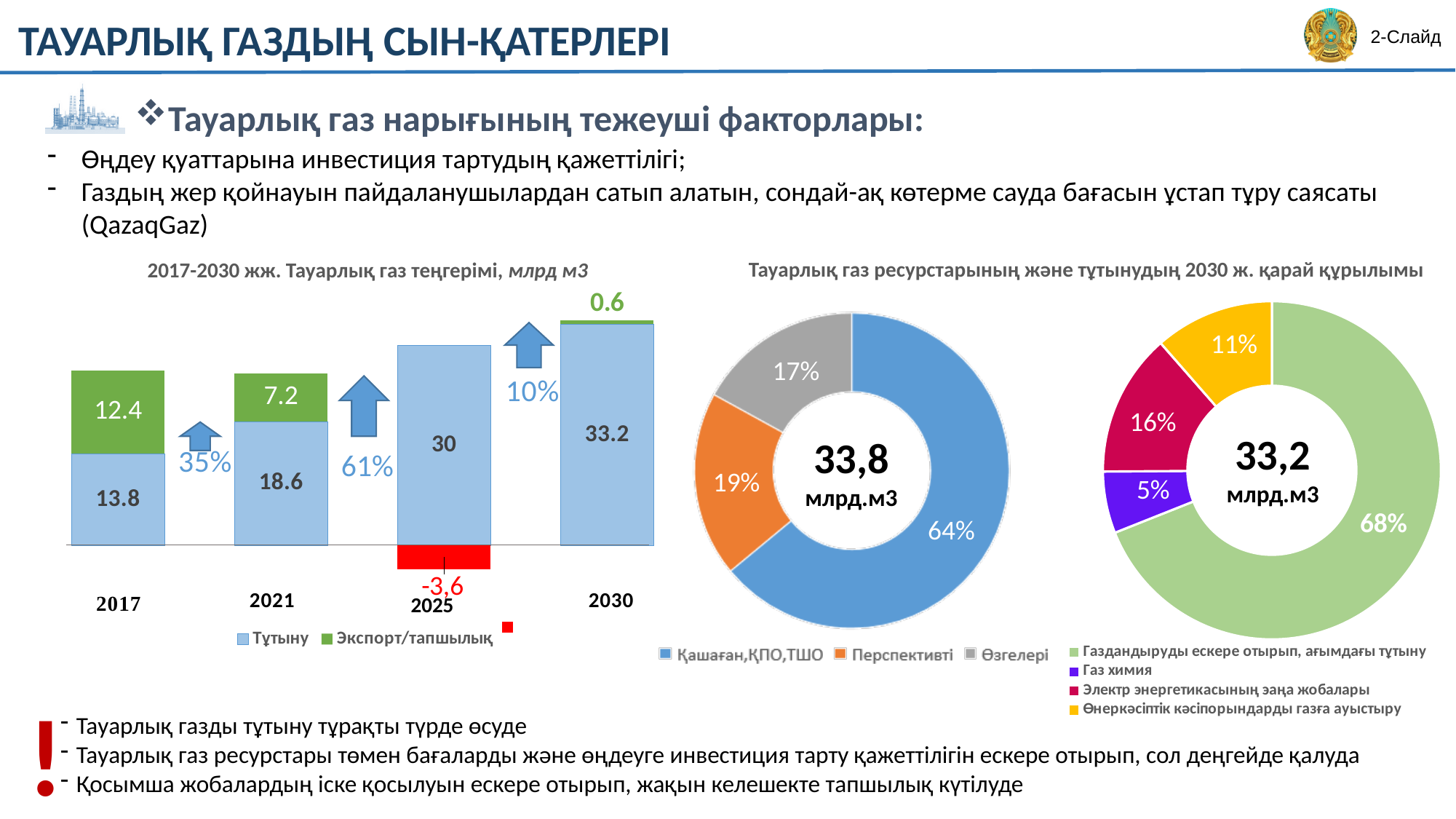
In the left donut chart under 'Тауарлық газ ресурстарының және тұтынудың 2030 ж. қарай құрылымы', what share is Перспективті? 19% In the bar chart '2017-2030 жж. Тауарлық газ теңгерімі', what is the Экспорт/тапшылық value for 2017? 12.4 In the bar chart '2017-2030 жж. Тауарлық газ теңгерімі', does the Тұтыну value rise or fall from 2017 to 2030? rise In the right donut chart under 'Тауарлық газ ресурстарының және тұтынудың 2030 ж. қарай құрылымы', what total value is printed in the centre? 33,2 млрд.м3 In the bar chart '2017-2030 жж. Тауарлық газ теңгерімі', what is the difference between the Тұтыну values for 2030 and 2025? 3.2 In the bar chart '2017-2030 жж. Тауарлық газ теңгерімі', how many years are shown on the x axis? 4 In the left donut chart under 'Тауарлық газ ресурстарының және тұтынудың 2030 ж. қарай құрылымы', which category has the largest share? Қашаған,ҚПО,ТШО In the bar chart '2017-2030 жж. Тауарлық газ теңгерімі', how many series does the legend list? 2 In the bar chart '2017-2030 жж. Тауарлық газ теңгерімі', which year has the highest Тұтыну value? 2030 In the right donut chart under 'Тауарлық газ ресурстарының және тұтынудың 2030 ж. қарай құрылымы', what share is Газ химия? 5% In the bar chart '2017-2030 жж. Тауарлық газ теңгерімі', what is the Тұтыну value for 2021? 18.6 In the bar chart '2017-2030 жж. Тауарлық газ теңгерімі', what is the Экспорт/тапшылық value for 2025? -3,6